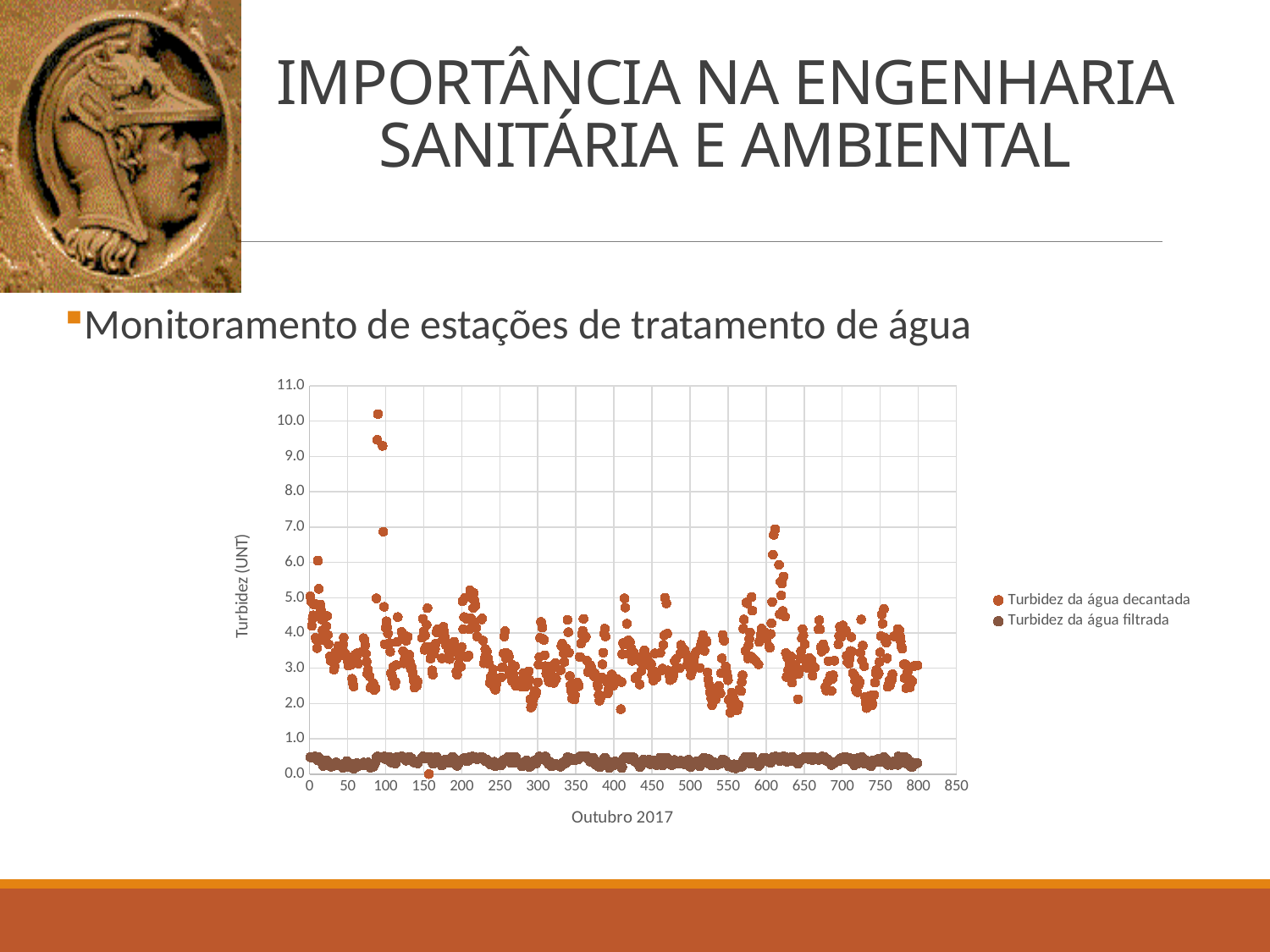
What is the maximum value shown on the vertical axis? 11.0 What kind of chart is shown on the slide? scatter chart Which series reaches the highest value on the chart? Turbidez da água decantada Is the highest value of the Turbidez da água decantada series greater or less than 9.0? greater What is the label of the vertical axis? Turbidez (UNT) Are the values of the Turbidez da água filtrada series greater or less than 1.0? less How many series does the legend list? 2 What are the two series named in the legend? Turbidez da água decantada; Turbidez da água filtrada Which series has larger values overall, Turbidez da água decantada or Turbidez da água filtrada? Turbidez da água decantada